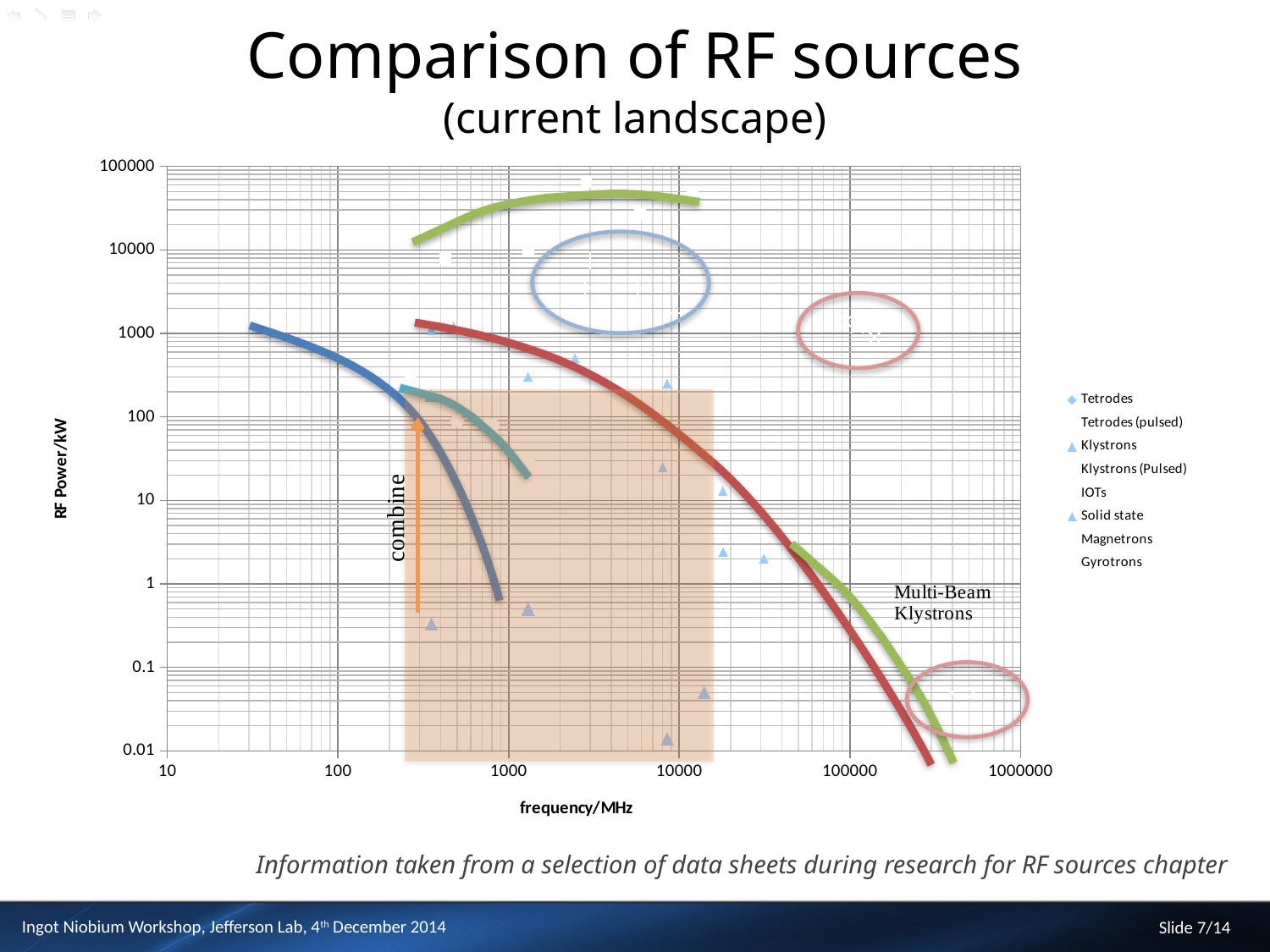
How many series does the legend list? 8 What kind of chart is shown on the slide? scatter chart Overall, do the plotted RF power values rise or fall as frequency increases? fall What is the highest value shown on the vertical axis? 100000 What is the label of the horizontal axis? frequency/MHz What is the lowest value shown on the vertical axis? 0.01 What is the label of the vertical axis? RF Power/kW